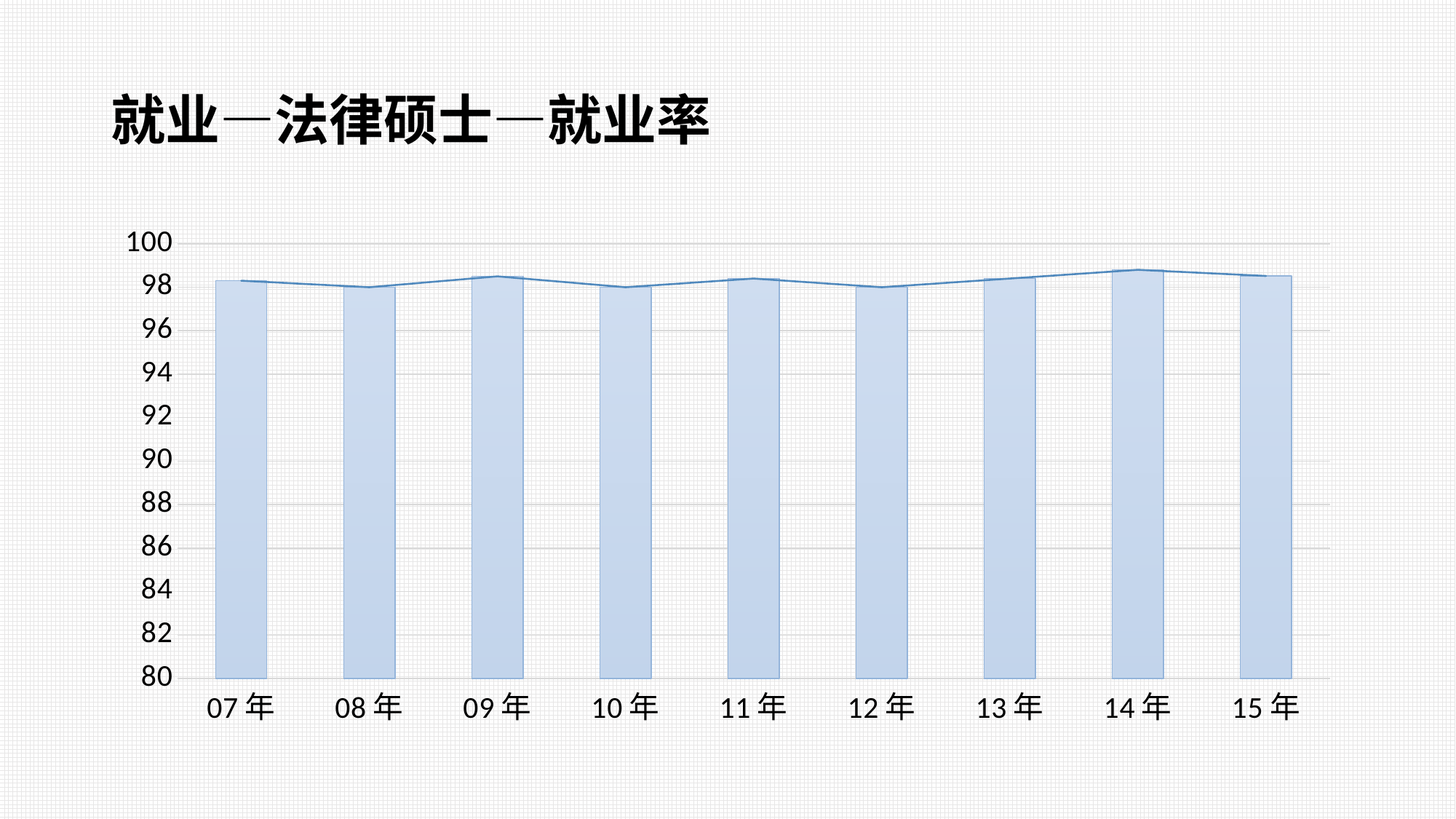
What kind of chart is shown on the slide? combination bar and line chart Which is larger, the value for 14年 or the value for 12年? 14年 Which is larger, the value for 09年 or the value for 10年? 09年 Which year has the highest value? 14年 What is the title of the slide? 就业—法律硕士—就业率 Is the value for 07年 greater or less than 96? greater What is the lowest value shown on the y axis? 80 Is the value for 14年 greater or less than 98? greater What is the first year shown on the x axis? 07年 Is the value for 12年 greater or less than 100? less How many years (categories) are plotted on the x axis? 9